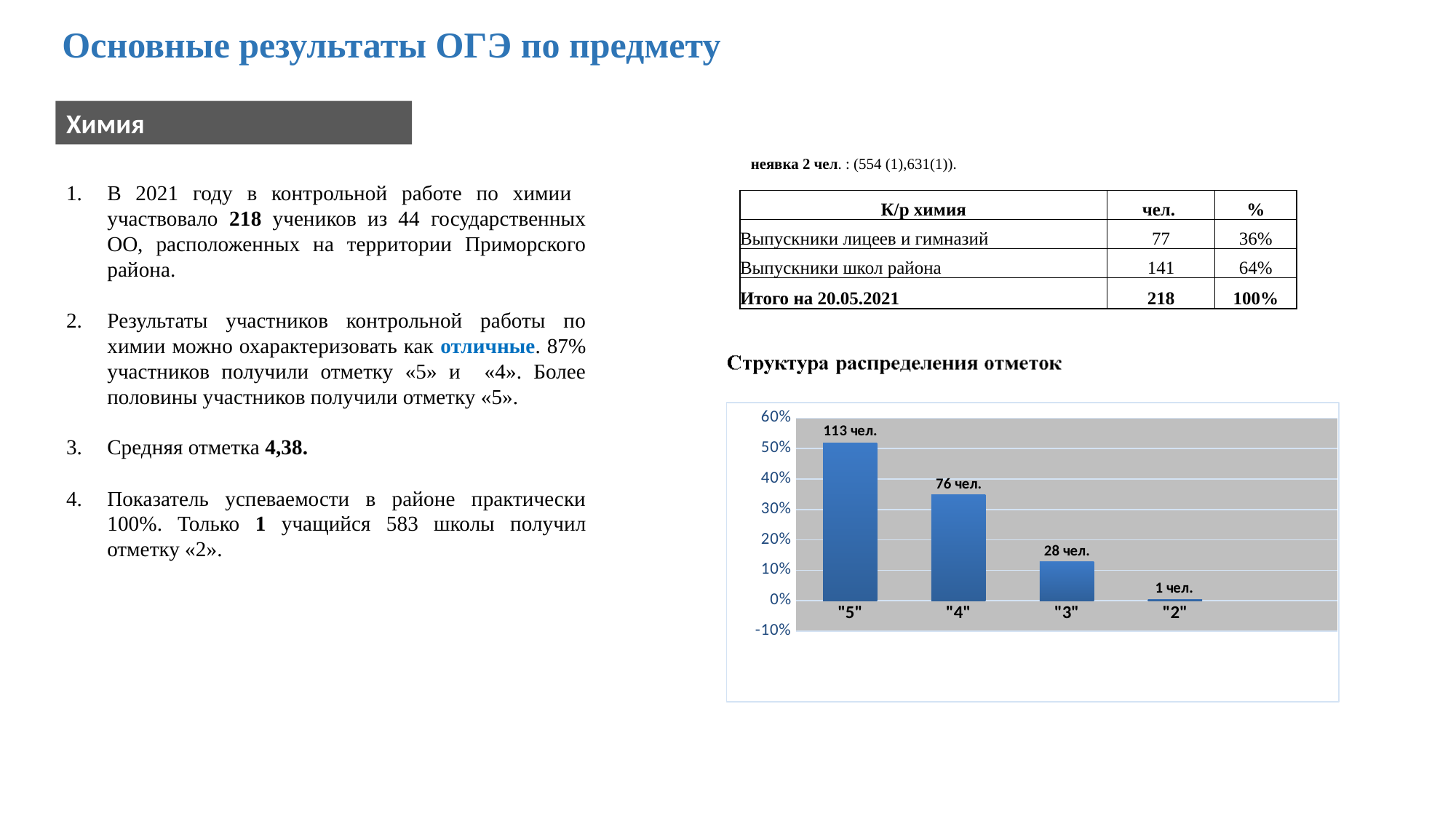
How many grade categories are shown in the chart "Структура распределения отметок"? 4 In the chart "Структура распределения отметок", which is larger: the number of people with grade "3" or with grade "4"? "4" Which grade category has the lowest bar in the chart "Структура распределения отметок"? "2" In the chart "Структура распределения отметок", how many more people received a "5" than a "4"? 37 чел. What is the data label for the "3" bar in the chart "Структура распределения отметок"? 28 чел. What type of chart is "Структура распределения отметок"? bar chart What is the data label for the "4" bar in the chart "Структура распределения отметок"? 76 чел. What is the data label for the "5" bar in the chart "Структура распределения отметок"? 113 чел. Which grade category has the highest bar in the chart "Структура распределения отметок"? "5" In the chart "Структура распределения отметок", is the value for "4" greater or less than 30%? greater In the chart "Структура распределения отметок", is the value for "3" greater or less than 20%? less What is the data label for the "2" bar in the chart "Структура распределения отметок"? 1 чел.